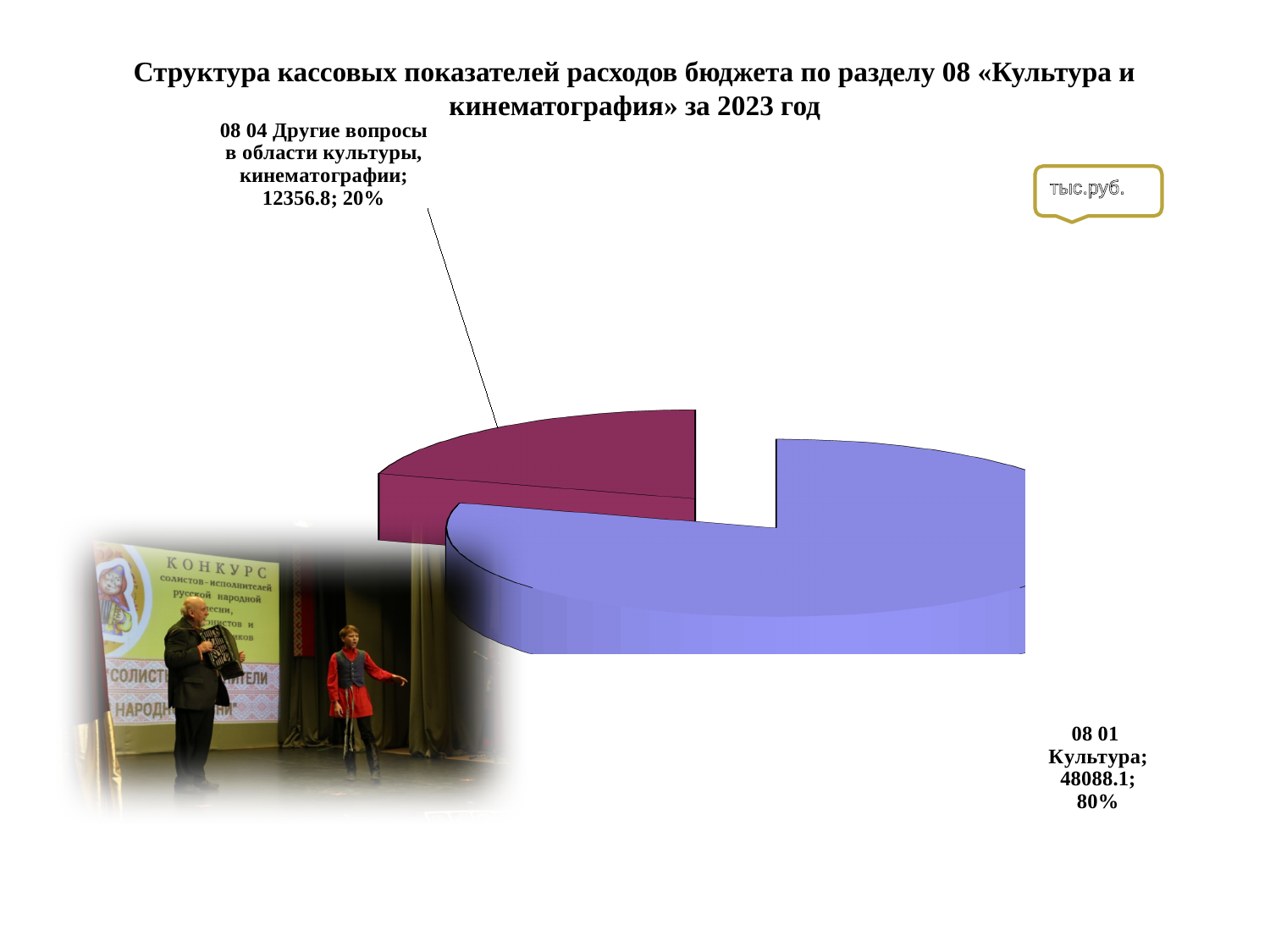
What is the value for "08 04 Другие вопросы в области культуры, кинематографии"? 12356.8 What is the value for "08 01 Культура"? 48088.1 What is the difference between the values for "08 01 Культура" and "08 04 Другие вопросы в области культуры, кинематографии"? 35731.3 What is the total of the two slices in the pie chart? 60444.9 What share of the pie does "08 01 Культура" represent? 80% Which slice is the smallest in the pie chart? 08 04 Другие вопросы в области культуры, кинематографии Which is larger: the value for "08 01 Культура" or for "08 04 Другие вопросы в области культуры, кинематографии"? 08 01 Культура Which slice is the largest in the pie chart? 08 01 Культура What kind of chart is shown on the slide? pie chart What share of the pie does "08 04 Другие вопросы в области культуры, кинематографии" represent? 20% What unit is indicated for the values in the chart? тыс.руб. How many slices does the pie chart have? 2